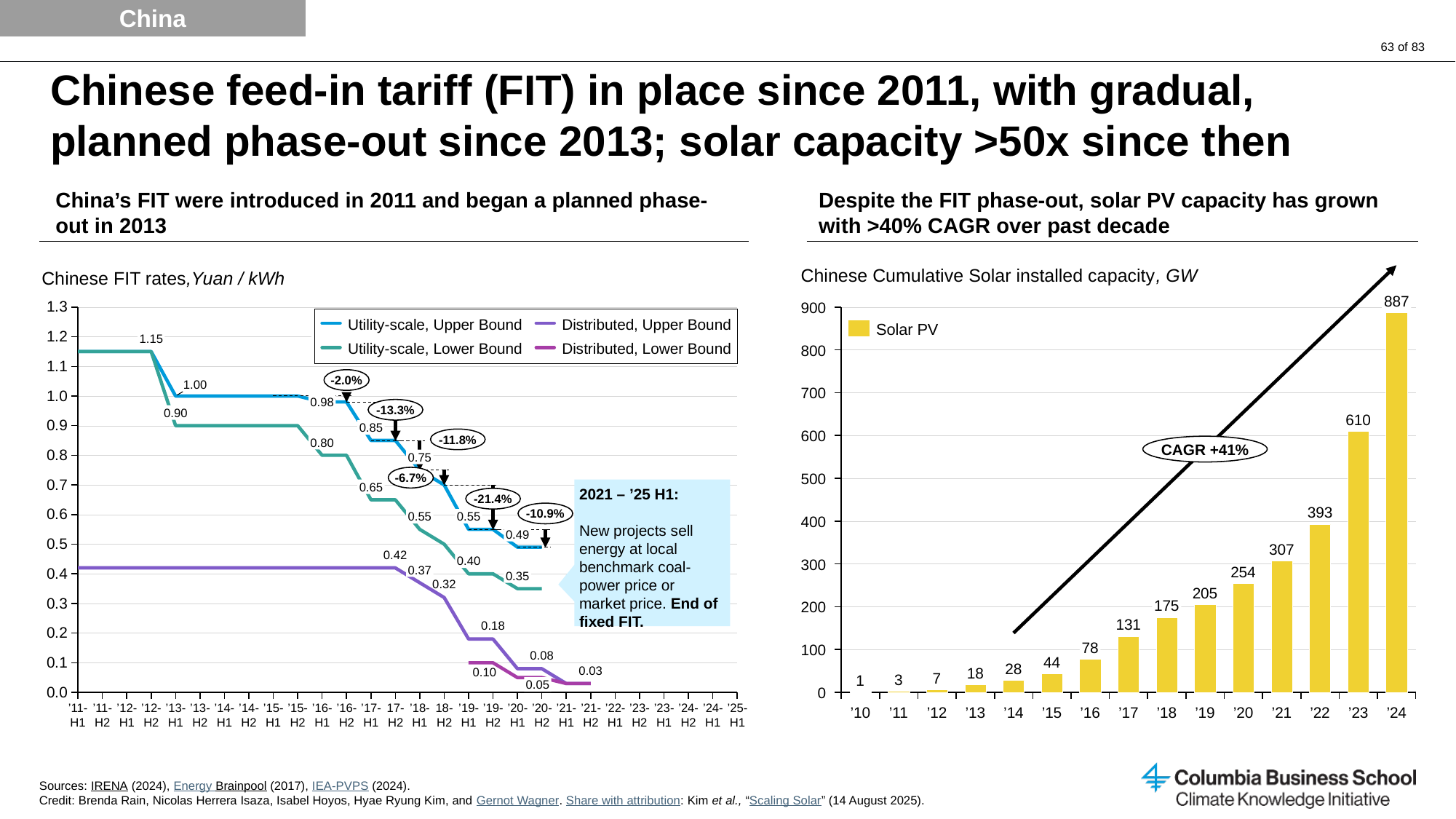
On the right chart (Chinese Cumulative Solar installed capacity), which year has the lowest value? '10 On the right chart (Chinese Cumulative Solar installed capacity), what is the value for '24? 887 On the left chart (Chinese FIT rates), what kind of chart is it? line chart On the left chart (Chinese FIT rates), what is the value of the Utility-scale, Upper Bound series at '11-H1? 1.15 On the right chart (Chinese Cumulative Solar installed capacity), what kind of chart is it? bar chart On the right chart (Chinese Cumulative Solar installed capacity), how many years are plotted? 15 On the left chart (Chinese FIT rates), what is the value of the Utility-scale, Upper Bound series at '20-H2? 0.49 On the right chart (Chinese Cumulative Solar installed capacity), what is the value for '17? 131 On the left chart (Chinese FIT rates), how many series does the legend list? 4 On the right chart (Chinese Cumulative Solar installed capacity), what is the difference between the values for '24 and '23? 277 On the left chart (Chinese FIT rates), do the Utility-scale, Upper Bound values rise or fall over time? fall On the right chart (Chinese Cumulative Solar installed capacity), do the values rise or fall from '10 to '24? rise